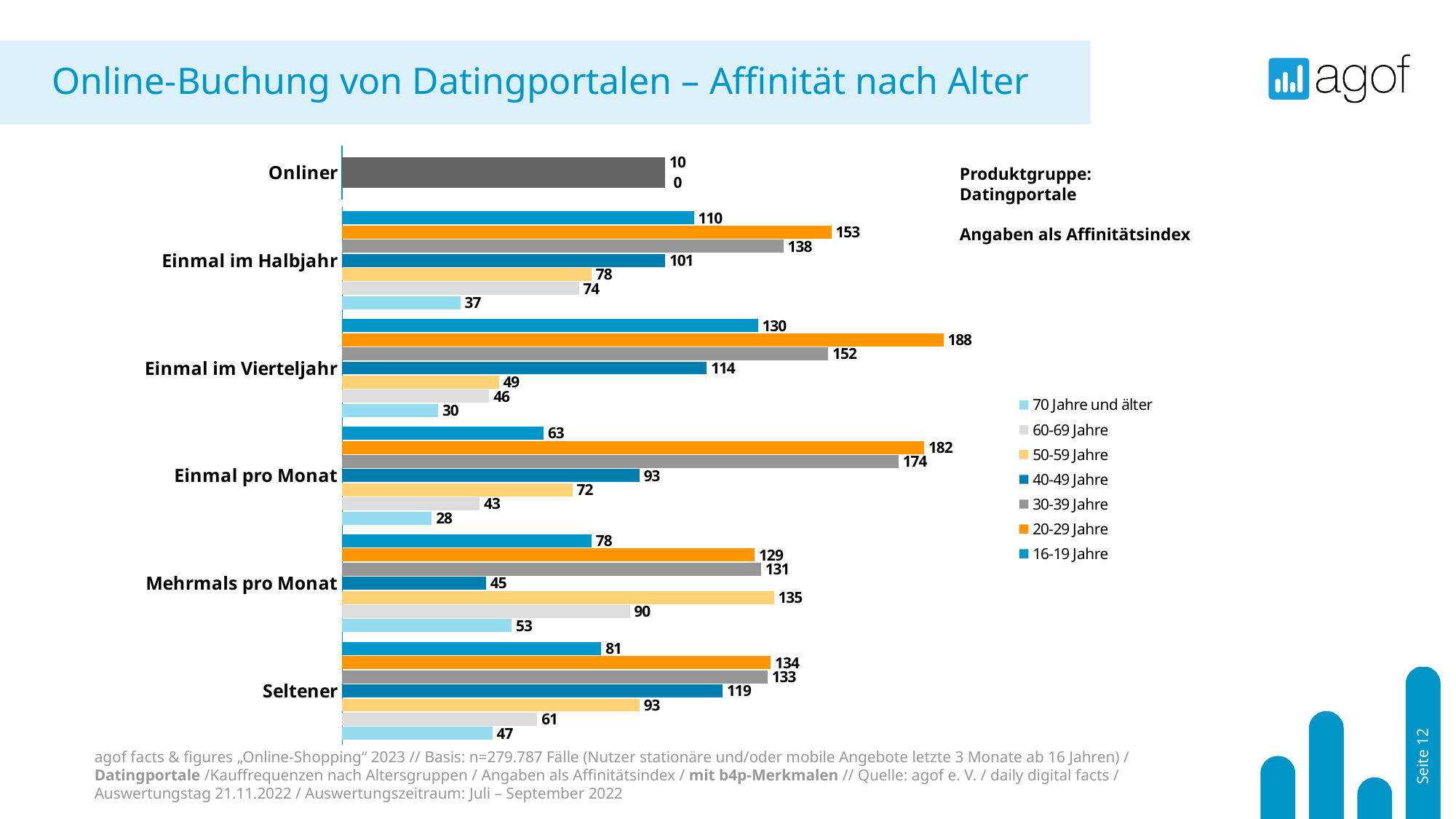
What is the value for 40-49 Jahre in the category Seltener? 119 What is the affinity index for 20-29 Jahre in the category Einmal im Vierteljahr? 188 In the category Einmal im Vierteljahr, how much higher is the value for 16-19 Jahre than for 40-49 Jahre? 16 What kind of chart is shown on the slide? bar chart Which age group has the lowest value in the category Seltener? 70 Jahre und älter What is the value for 70 Jahre und älter in the category Einmal pro Monat? 28 In the category Einmal im Halbjahr, what is the difference between the values for 20-29 Jahre and 30-39 Jahre? 15 In the category Mehrmals pro Monat, which is larger: the value for 50-59 Jahre or for 30-39 Jahre? 50-59 Jahre Which age group has the highest value in the category Einmal pro Monat? 20-29 Jahre How many series does the legend list? 7 For the 20-29 Jahre series, which category has the highest value? Einmal im Vierteljahr How many categories are shown on the vertical axis of the chart? 6